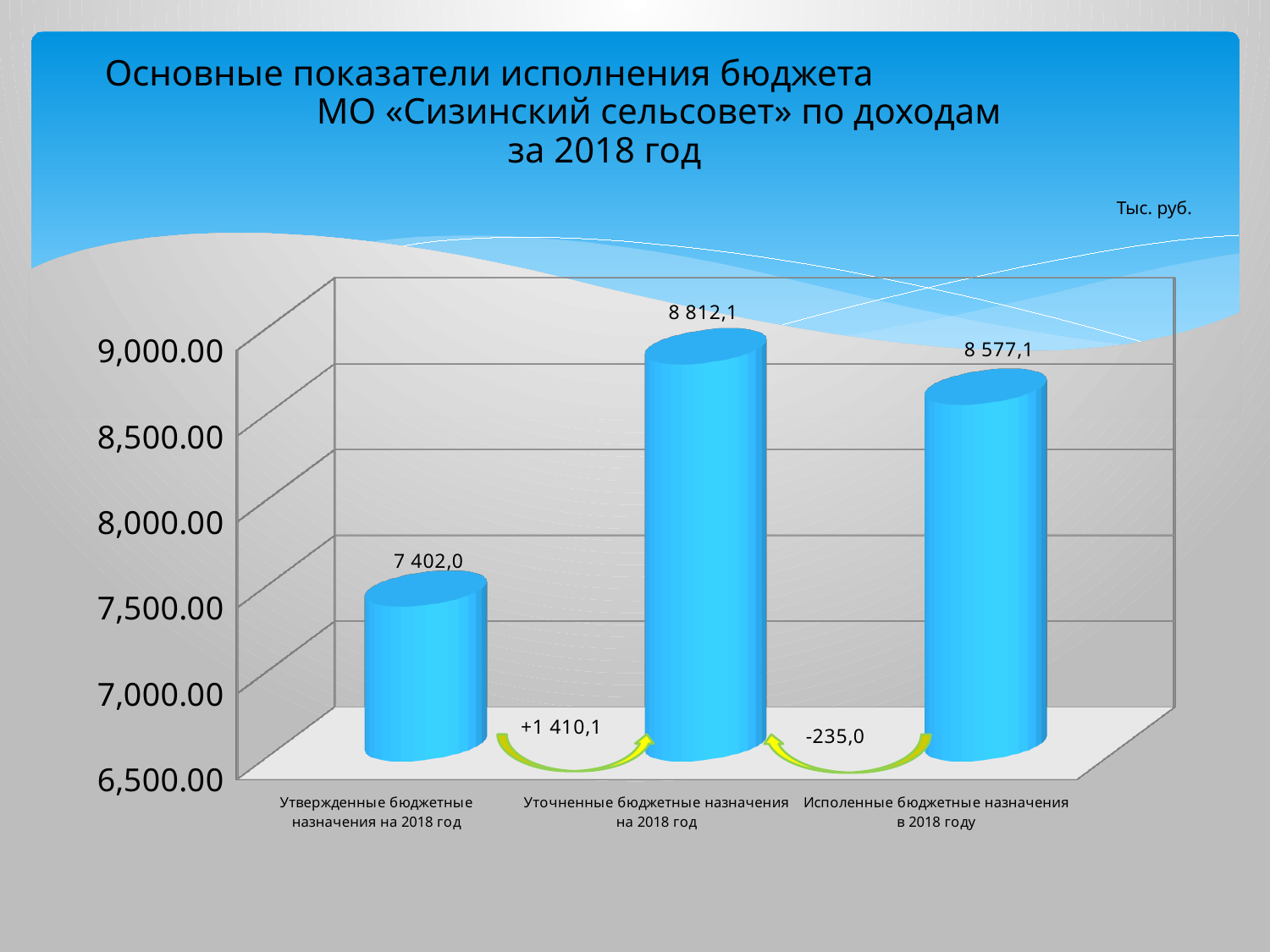
How many categories are shown on the chart? 3 Which category has the highest value? Уточненные бюджетные назначения на 2018 год What is the value for «Исполненные бюджетные назначения в 2018 году»? 8 577,1 Which is larger: «Исполненные бюджетные назначения в 2018 году» or «Утвержденные бюджетные назначения на 2018 год»? Исполненные бюджетные назначения в 2018 году What is the difference between «Уточненные бюджетные назначения на 2018 год» and «Утвержденные бюджетные назначения на 2018 год»? 1 410,1 Is the value for «Утвержденные бюджетные назначения на 2018 год» greater or less than 7,500.00? less Which category has the lowest value? Утвержденные бюджетные назначения на 2018 год What unit of measurement is indicated for the chart values? Тыс. руб. What is the value for «Утвержденные бюджетные назначения на 2018 год»? 7 402,0 What is the value for «Уточненные бюджетные назначения на 2018 год»? 8 812,1 What kind of chart is shown on the slide? bar chart What is the difference between «Уточненные бюджетные назначения на 2018 год» and «Исполненные бюджетные назначения в 2018 году»? 235,0